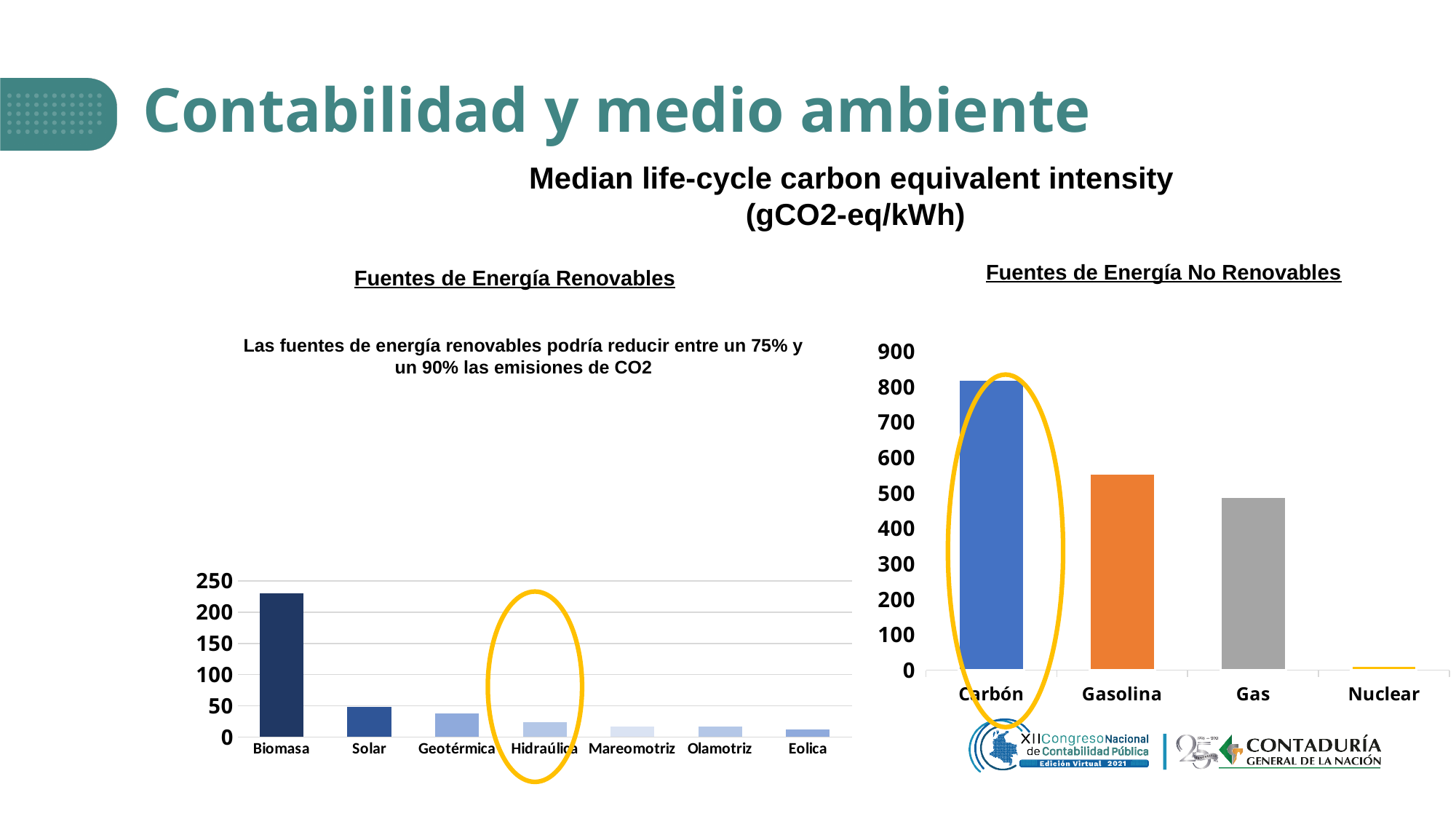
In the Fuentes de Energía Renovables chart, is the value for Biomasa greater or less than 200? greater In the Fuentes de Energía Renovables chart, which category has the highest value? Biomasa In the Fuentes de Energía No Renovables chart, which category has the lowest value? Nuclear What kind of chart is the Fuentes de Energía No Renovables chart? bar chart In the Fuentes de Energía Renovables chart, which is larger, Solar or Hidraúlica? Solar In the Fuentes de Energía No Renovables chart, do the values rise or fall from Carbón to Nuclear? fall In the Fuentes de Energía No Renovables chart, which category has the highest value? Carbón In the Fuentes de Energía No Renovables chart, is the value for Carbón greater or less than 800? greater In the Fuentes de Energía Renovables chart, is the value for Solar greater or less than 100? less In the Fuentes de Energía Renovables chart, which category has the lowest value? Eolica How many categories are shown in the Fuentes de Energía Renovables chart? 7